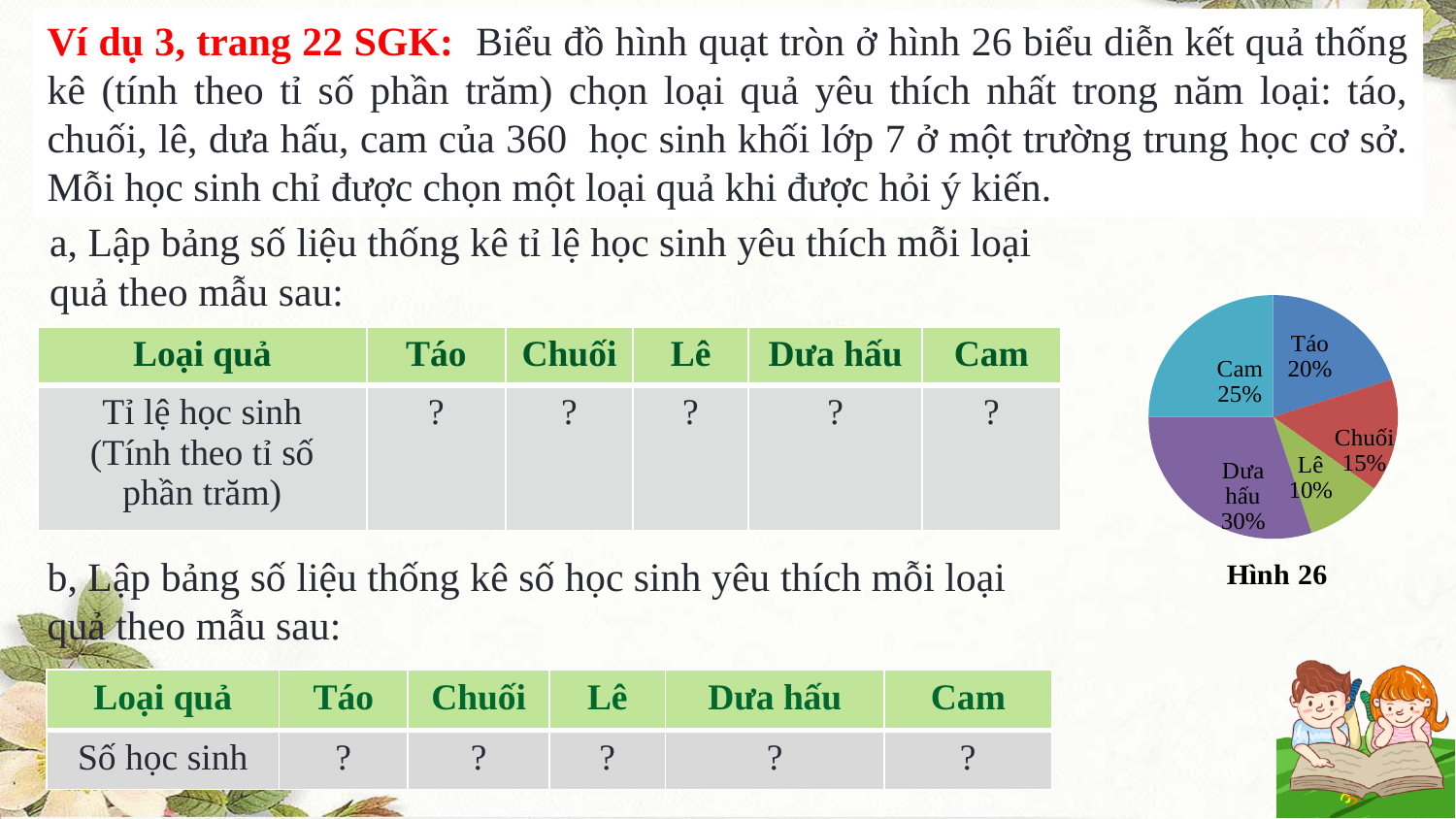
What is the caption label under the pie chart? Hình 26 In the pie chart (Hình 26), which fruit has the smallest share? Lê In the pie chart (Hình 26), what is the difference in percentage points between Dưa hấu and Chuối? 15 In the pie chart (Hình 26), what percentage is shown for Dưa hấu? 30% What kind of chart is shown in Hình 26? pie chart In the pie chart (Hình 26), which fruit has the largest share? Dưa hấu In the pie chart (Hình 26), which has a larger share, Cam or Táo? Cam In the pie chart (Hình 26), what share of the pie does Chuối represent? 15% In the pie chart (Hình 26), what percentage is shown for Lê? 10% In the pie chart (Hình 26), what percentage is shown for Táo? 20% How many slices does the pie chart (Hình 26) have? 5 In the pie chart (Hình 26), what percentage is shown for Cam? 25%